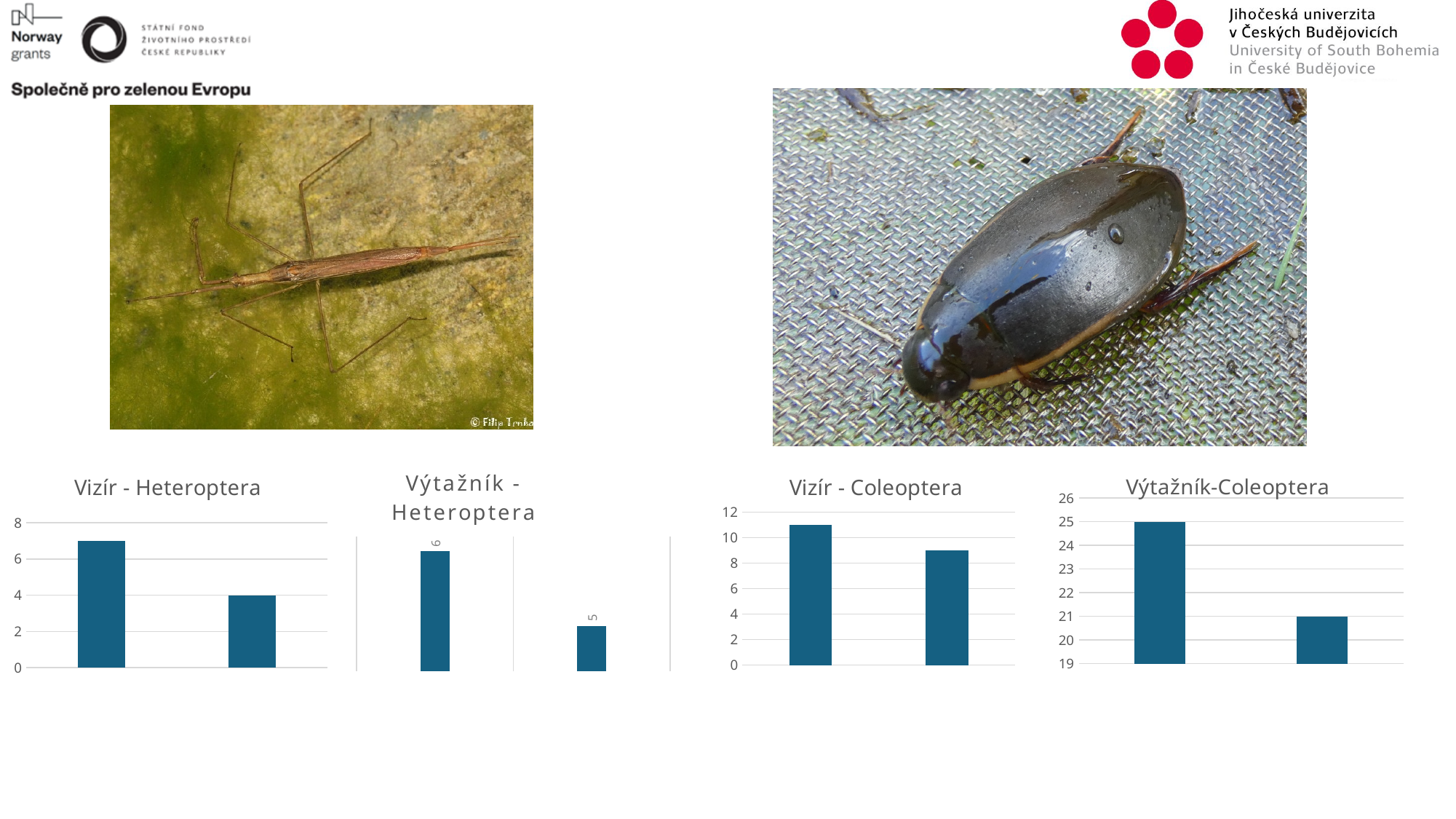
In the "Výtažník - Heteroptera" chart, what is the value of the left bar? 6 In the "Výtažník - Heteroptera" chart, what is the value of the right bar? 5 In the "Výtažník-Coleoptera" chart, what is the value of the right bar? 21 In the "Vizír - Heteroptera" chart, is the value of the left bar greater or less than 6? greater How many bars does the "Vizír - Coleoptera" chart show? 2 In the "Výtažník-Coleoptera" chart, what is the value of the left bar? 25 In the "Výtažník-Coleoptera" chart, what is the difference between the left bar and the right bar? 4 In the "Výtažník - Heteroptera" chart, what is the difference between the left bar and the right bar? 1 In the "Vizír - Heteroptera" chart, what is the value of the right bar? 4 In the "Vizír - Coleoptera" chart, is the value of the left bar greater or less than 10? greater What kind of chart is the "Vizír - Heteroptera" chart? bar chart In the "Vizír - Coleoptera" chart, which bar is higher, the left or the right? left